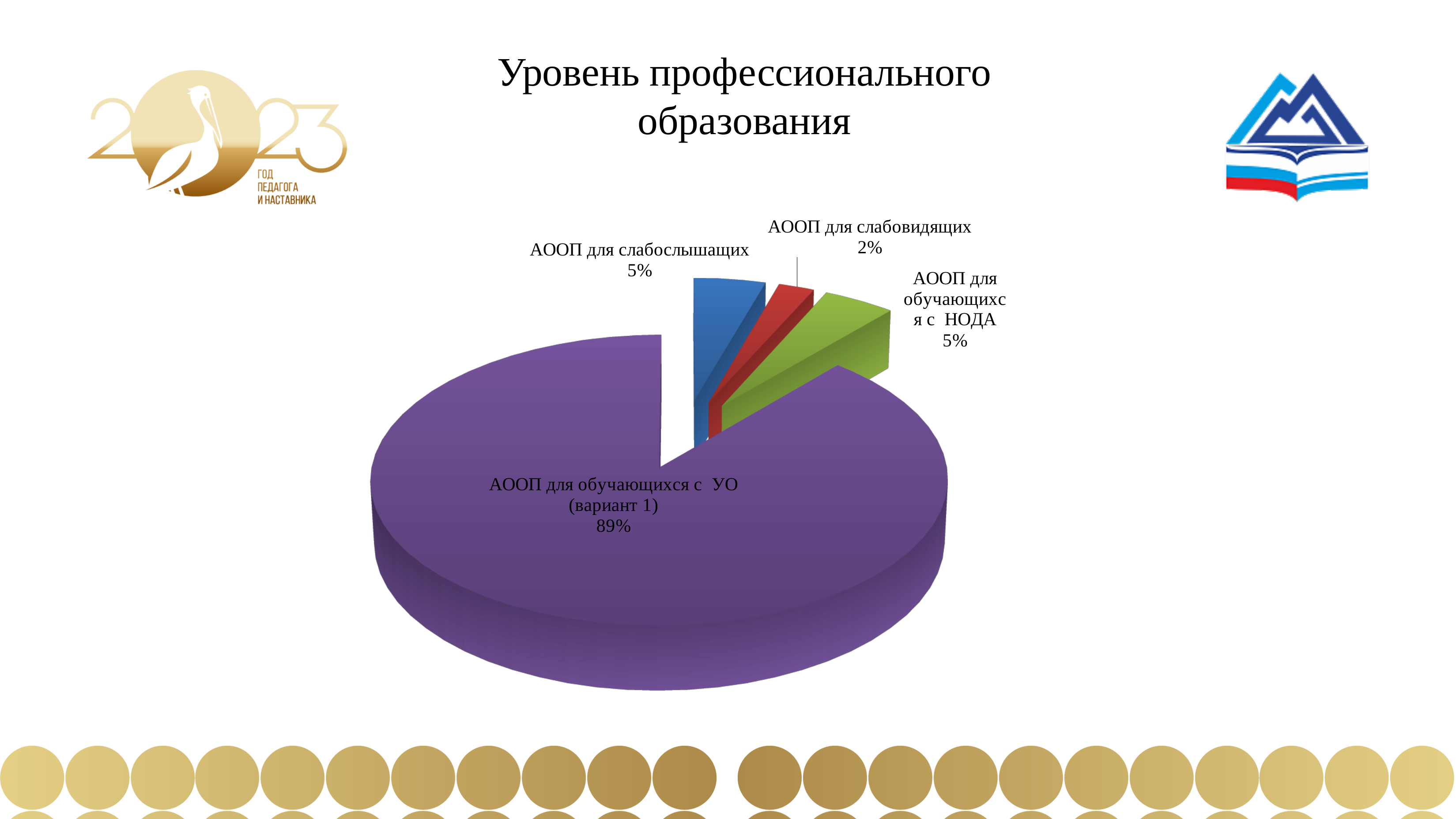
Which category has the largest slice of the pie? АООП для обучающихся с УО (вариант 1) Which category has the smallest slice of the pie? АООП для слабовидящих What colour is the largest slice of the pie chart? Purple What kind of chart is shown on the slide? Pie chart What share of the pie is labelled "АООП для обучающихся с НОДА"? 5% What share of the pie is labelled "АООП для слабовидящих"? 2% How many slices does the pie chart have? 4 What share of the pie is labelled "АООП для слабослышащих"? 5% What is the difference in percentage points between the "АООП для обучающихся с УО (вариант 1)" slice and the "АООП для слабовидящих" slice? 87 Which slice is larger: "АООП для слабослышащих" or "АООП для слабовидящих"? АООП для слабослышащих What is the title of the slide above the chart? Уровень профессионального образования